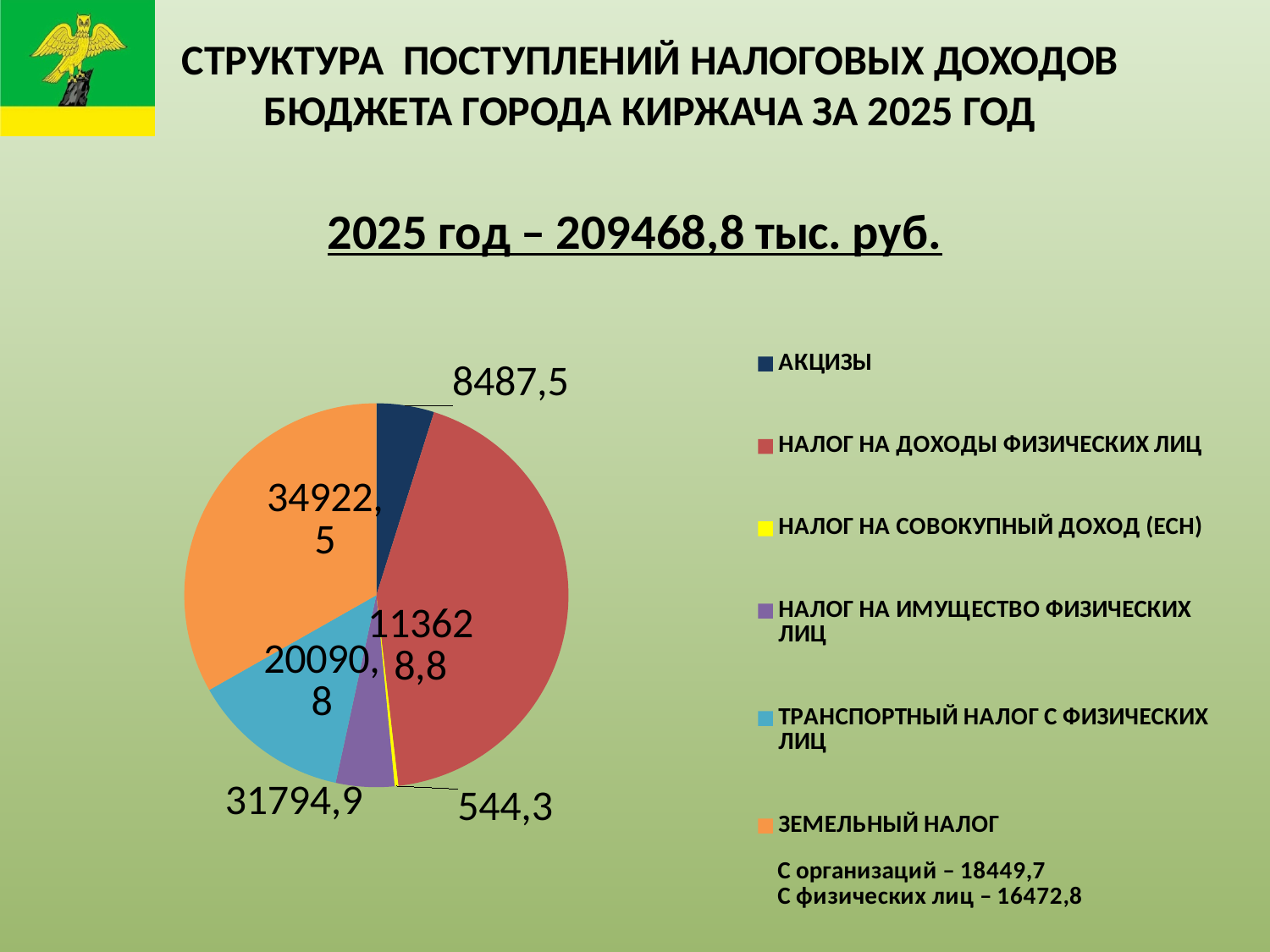
What is the value shown for НАЛОГ НА СОВОКУПНЫЙ ДОХОД (ЕСН) in the pie chart? 544,3 What is the value shown for ЗЕМЕЛЬНЫЙ НАЛОГ in the pie chart? 34922,5 Which is larger in the pie chart: АКЦИЗЫ or ЗЕМЕЛЬНЫЙ НАЛОГ? ЗЕМЕЛЬНЫЙ НАЛОГ What total amount for 2025 is stated above the pie chart? 209468,8 тыс. руб. How many entries does the legend of the pie chart list? 6 How many slices does the pie chart have? 6 Which category has the largest slice in the pie chart? НАЛОГ НА ДОХОДЫ ФИЗИЧЕСКИХ ЛИЦ What type of chart is shown on the slide? Pie chart What is the difference between the values for ЗЕМЕЛЬНЫЙ НАЛОГ and АКЦИЗЫ in the pie chart? 26435 What is the value shown for АКЦИЗЫ in the pie chart? 8487,5 What is the value shown for НАЛОГ НА ДОХОДЫ ФИЗИЧЕСКИХ ЛИЦ in the pie chart? 113628,8 Which category has the smallest slice in the pie chart? НАЛОГ НА СОВОКУПНЫЙ ДОХОД (ЕСН)